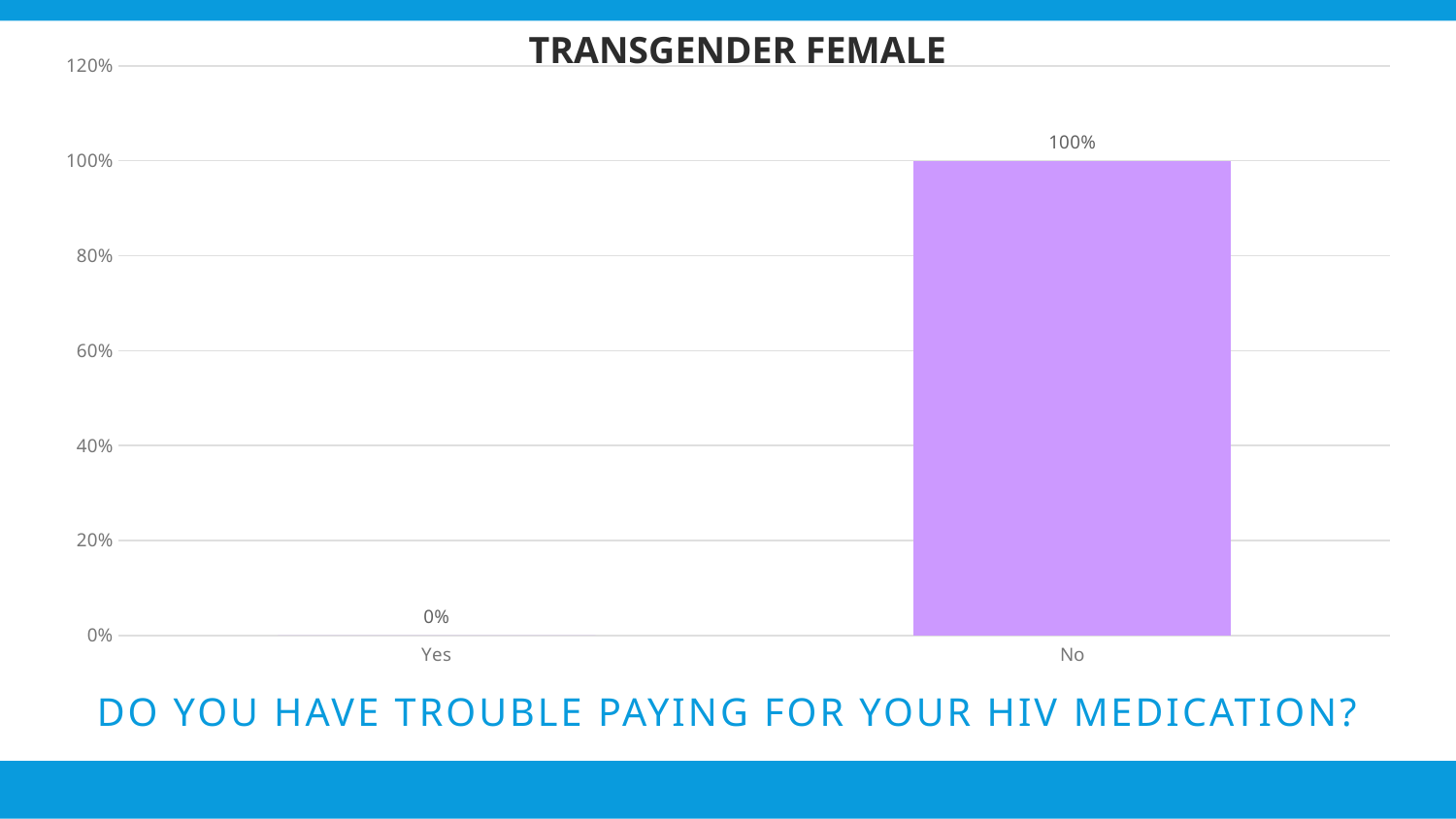
Which is larger, the value for "Yes" or the value for "No"? No What is the difference between the values for "No" and "Yes"? 100% What is the value for "No"? 100% Which category has the highest value? No How many categories are shown on the x axis? 2 What is the title of the chart? TRANSGENDER FEMALE What is the highest value shown on the y axis? 120% Which category has the lowest value? Yes Is the value for "No" greater or less than 80%? greater What is the value for "Yes"? 0% What kind of chart is shown on the slide? bar chart